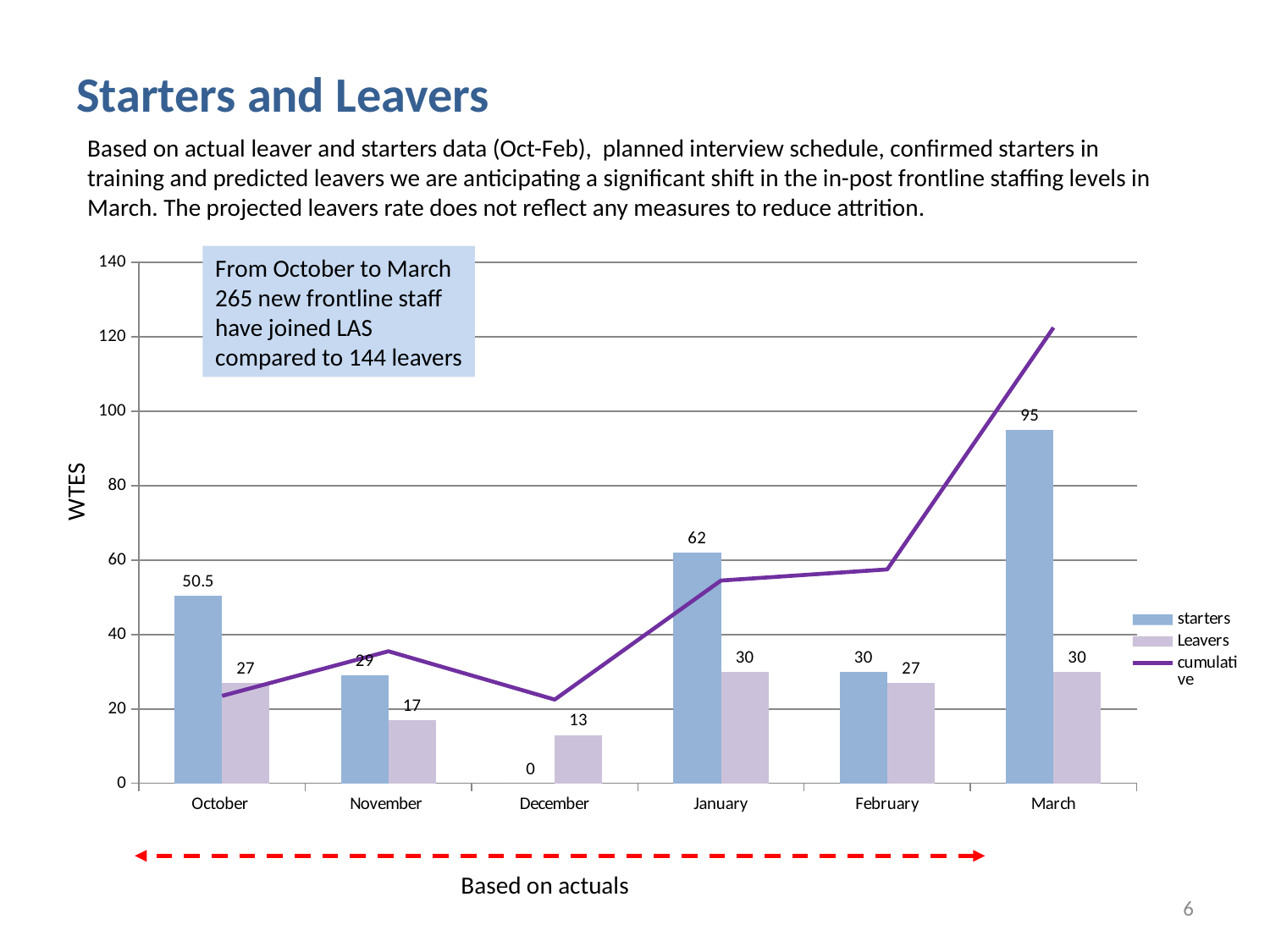
Is the cumulative line value for March greater or less than 100? greater Which month has the highest number of starters? March Which is larger, the starters value for October or for January? January What is the value for Leavers in December? 13 What is the difference between starters and Leavers in January? 32 Which month has the lowest number of Leavers? December What kind of chart is used for the starters and Leavers data? bar chart How many months are shown on the x axis? 6 What is the value for starters in October? 50.5 What is the label on the y axis? WTES How many series does the legend list? 3 What is the value for starters in March? 95